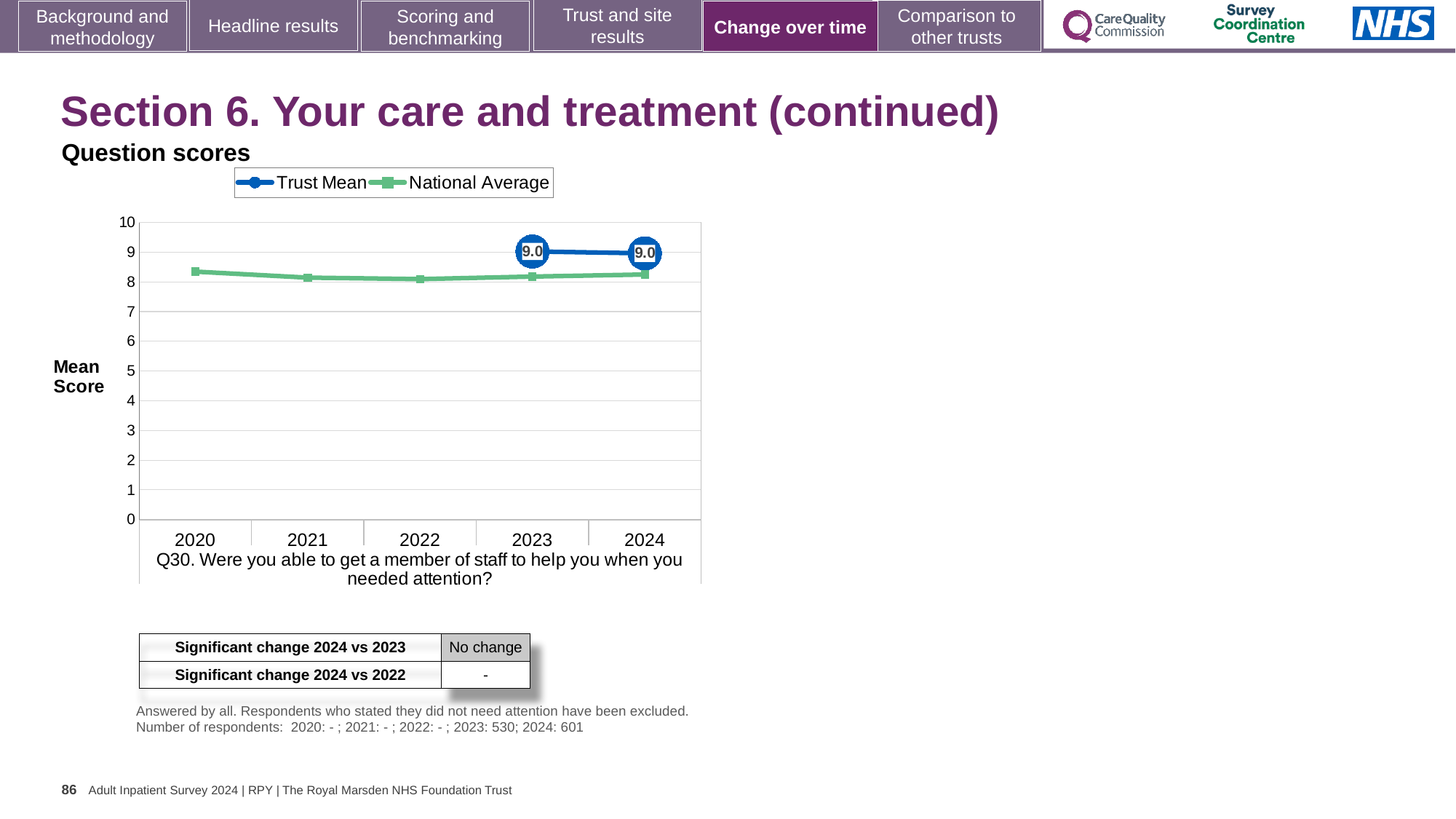
What is the Trust Mean score for 2023? 9.0 Which is the first year for which a Trust Mean value is plotted? 2023 What is the label on the y axis of the chart? Mean Score What is the Trust Mean score for 2024? 9.0 Is the National Average value for 2020 greater or less than 8? greater What is the difference between the Trust Mean in 2024 and the Trust Mean in 2023? 0.0 Is the National Average value for 2020 greater or less than 9? less Does the Trust Mean rise, fall or stay the same from 2023 to 2024? Stays the same What kind of chart is shown on the slide? Line chart How many series does the legend list? 2 How many years are shown on the x axis? 5 In 2024, which is larger: the Trust Mean or the National Average? Trust Mean